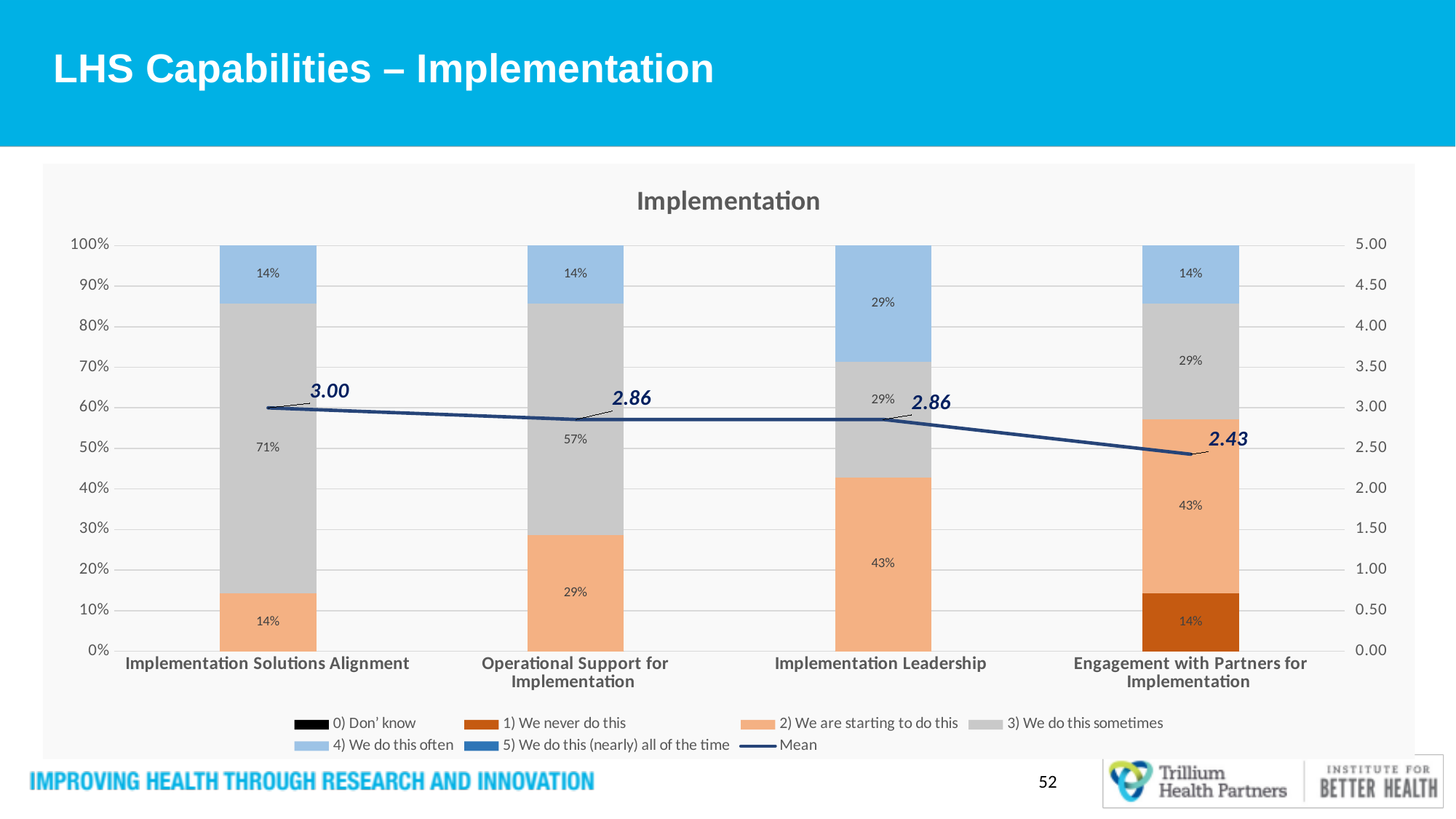
What is the difference between the mean for Implementation Solutions Alignment and the mean for Engagement with Partners for Implementation? 0.57 Which category has the highest mean value? Implementation Solutions Alignment What percentage of respondents chose '3) We do this sometimes' for Implementation Solutions Alignment? 71% Does the mean line rise or fall from left to right across the categories? Fall Which category has the lowest mean value? Engagement with Partners for Implementation What percentage of respondents chose '1) We never do this' for Engagement with Partners for Implementation? 14% What percentage of respondents chose '2) We are starting to do this' for Implementation Leadership? 43% What is the mean value for Implementation Solutions Alignment? 3.00 How many categories are shown on the x axis? 4 What is the mean value for Engagement with Partners for Implementation? 2.43 Which is larger: the '3) We do this sometimes' share for Implementation Solutions Alignment or for Operational Support for Implementation? Implementation Solutions Alignment How many entries does the legend list? 7